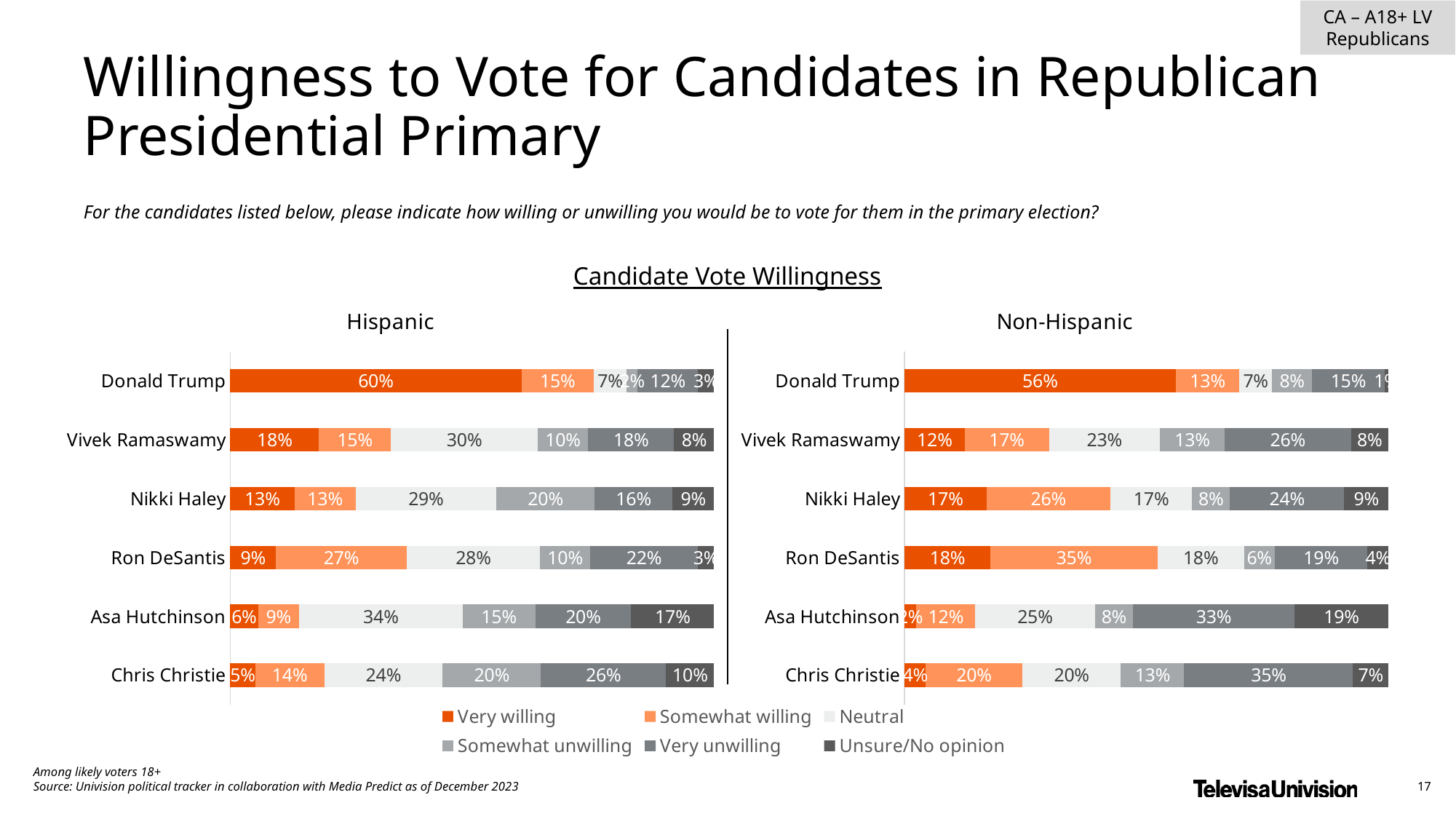
In the Hispanic chart, what is the combined Very willing and Somewhat willing percentage for Ron DeSantis? 36% In the Non-Hispanic chart, what percentage of respondents are somewhat willing to vote for Ron DeSantis? 35% In the Non-Hispanic chart, which candidate has the lowest Very unwilling percentage? Donald Trump In the Hispanic chart, what percentage of respondents are very willing to vote for Donald Trump? 60% In the Hispanic chart, what is the Neutral value for Asa Hutchinson? 34% In the Non-Hispanic chart, which candidate has a higher Somewhat willing percentage, Nikki Haley or Vivek Ramaswamy? Nikki Haley In the Non-Hispanic chart, what is the Very unwilling value for Chris Christie? 35% In the Hispanic chart, which candidate has the highest Very willing percentage? Donald Trump In the Hispanic chart, what is the difference between the Very willing percentages for Vivek Ramaswamy and Nikki Haley? 5% How many series does the legend list? 6 What type of chart is used for the Non-Hispanic data? Stacked bar chart How many candidates are shown in the Hispanic chart? 6